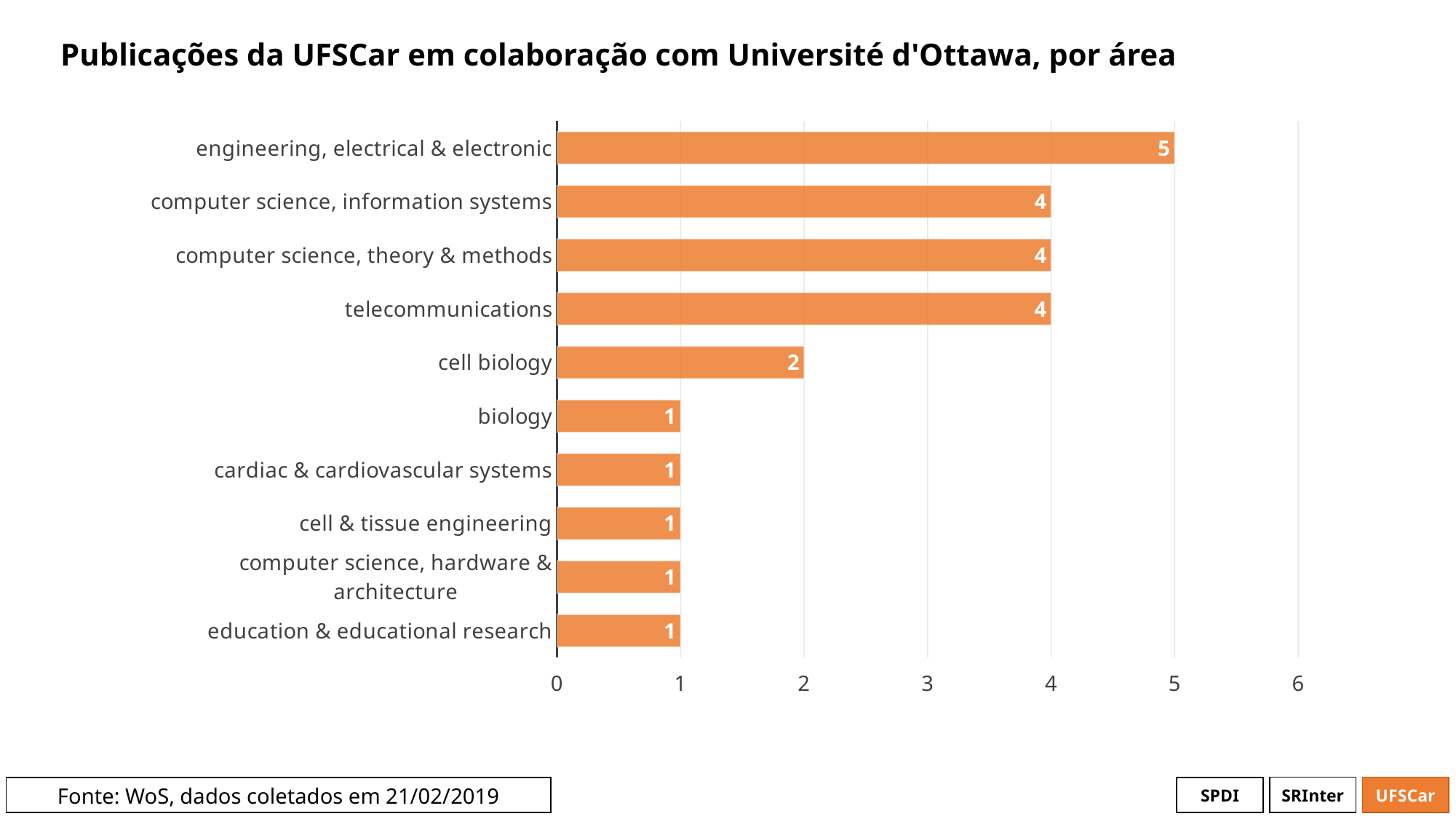
How many publications are shown for engineering, electrical & electronic? 5 What kind of chart is shown on the slide? bar chart What is the title of the chart? Publicações da UFSCar em colaboração com Université d'Ottawa, por área How many areas have a value of 1? 5 What is the difference between the values for computer science, information systems and biology? 3 What is the difference between the values for engineering, electrical & electronic and cell biology? 3 Which area has the highest number of publications? engineering, electrical & electronic How many areas are shown in the chart? 10 What is the value for cell biology? 2 What colour are the bars in the chart? orange Which is larger, the value for telecommunications or the value for cell biology? telecommunications What is the value for telecommunications? 4